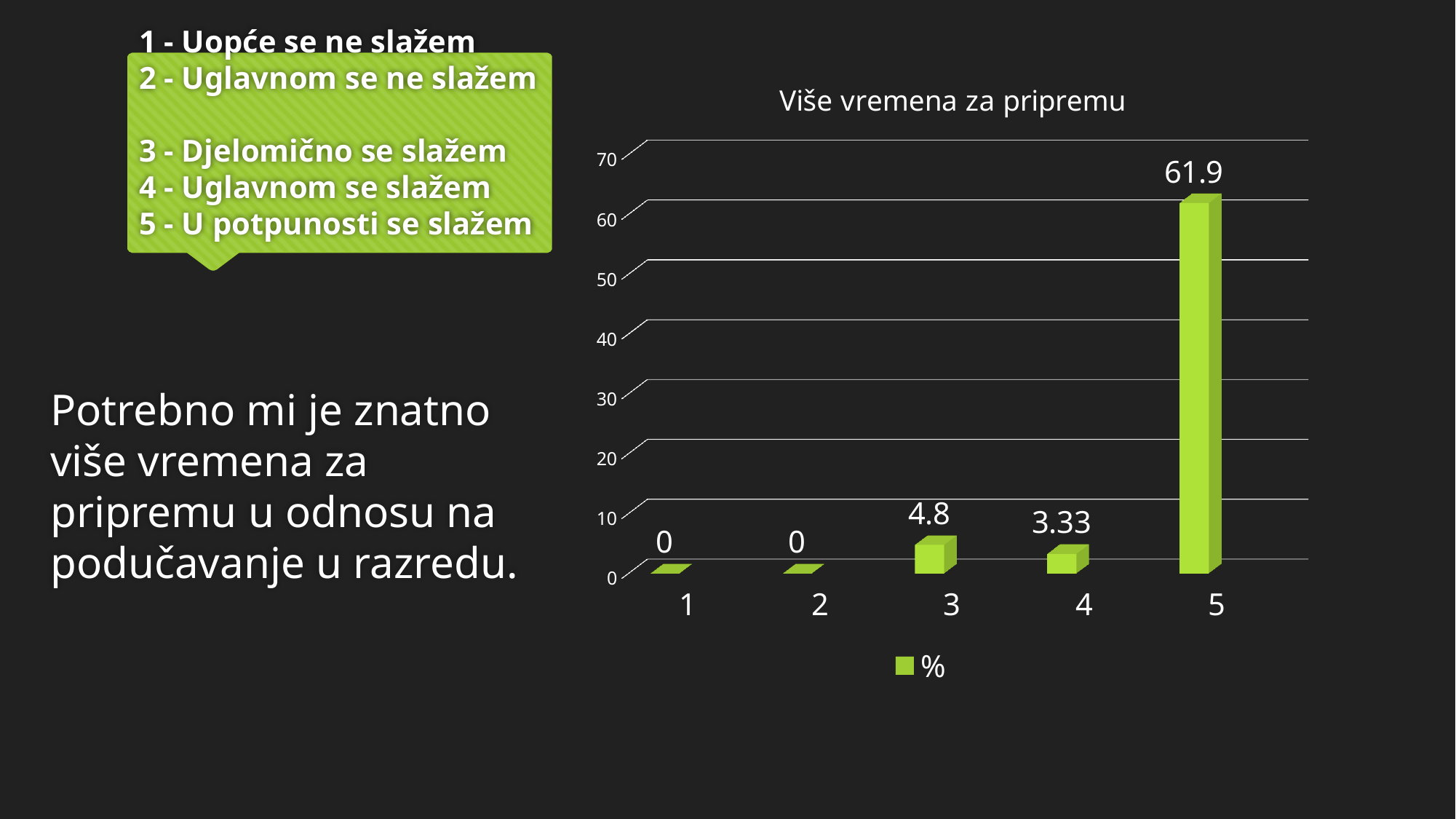
What is the difference between the values for category 5 and category 3? 57.1 What is the value for category 3? 4.8 Which is larger, the value for category 3 or category 4? 3 How many categories are shown on the x axis? 5 What is the value for category 4? 3.33 Which category has the highest value? 5 How many series does the legend list? 1 What is the value for category 5? 61.9 What is the title of the chart? Više vremena za pripremu Is the value for category 5 greater or less than 60? greater What kind of chart is shown? bar chart What is the value for category 1? 0